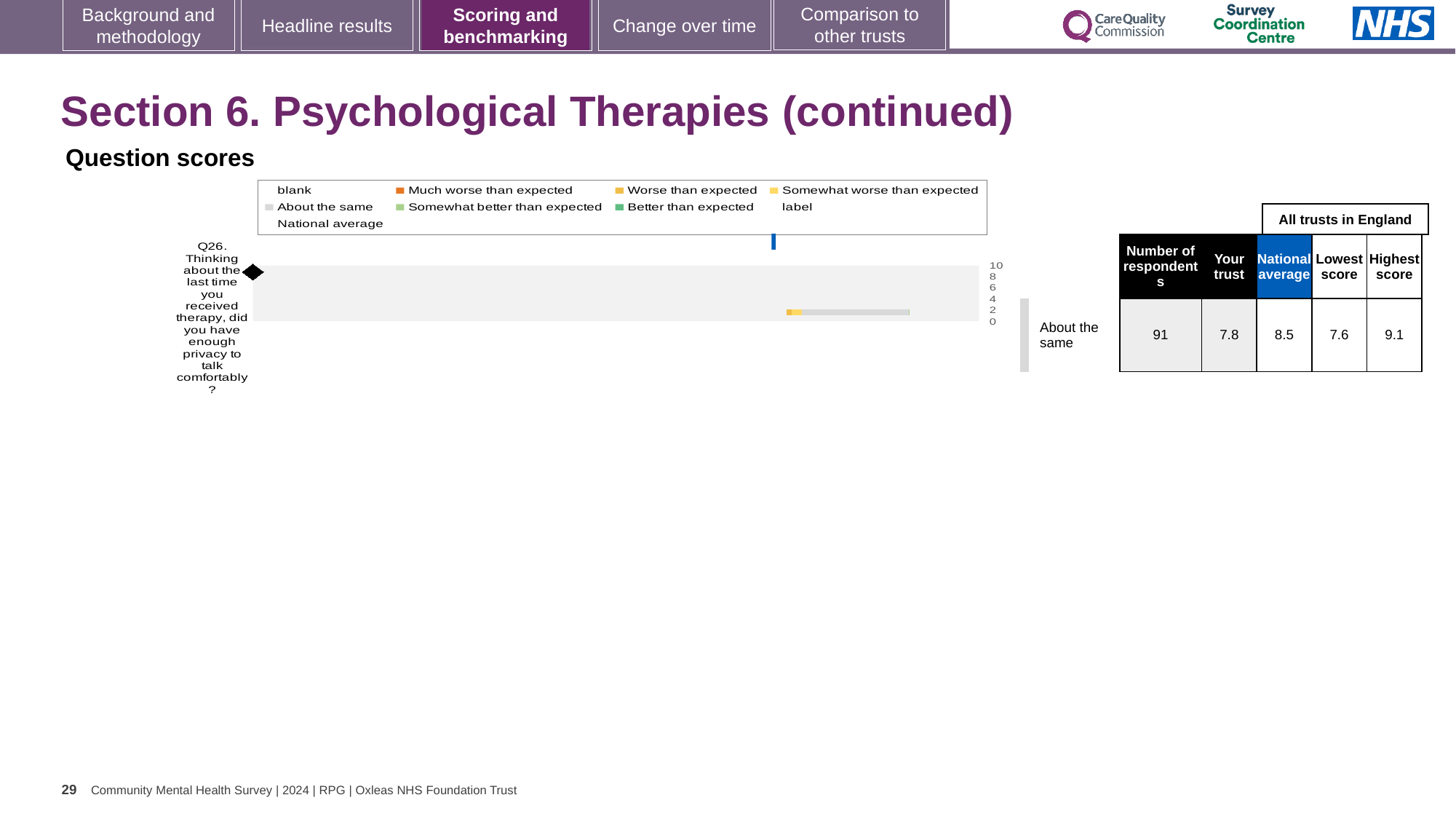
What is the national average score for Q26? 8.5 What is the highest value shown on the chart's axis? 10 How many questions (categories) are plotted on the chart? 1 What is the difference between the national average and the 'Your trust' score for Q26? 0.7 Which question is plotted on the chart? Q26. Thinking about the last time you received therapy, did you have enough privacy to talk comfortably? What is the 'Your trust' score for Q26? 7.8 What is the lowest score among all trusts in England for Q26? 7.6 How many respondents answered Q26? 91 What is the highest score among all trusts in England for Q26? 9.1 Which is larger for Q26, the 'Your trust' score or the national average? National average What is the difference between the highest and lowest scores among all trusts in England for Q26? 1.5 What kind of chart is shown under 'Question scores'? bar chart